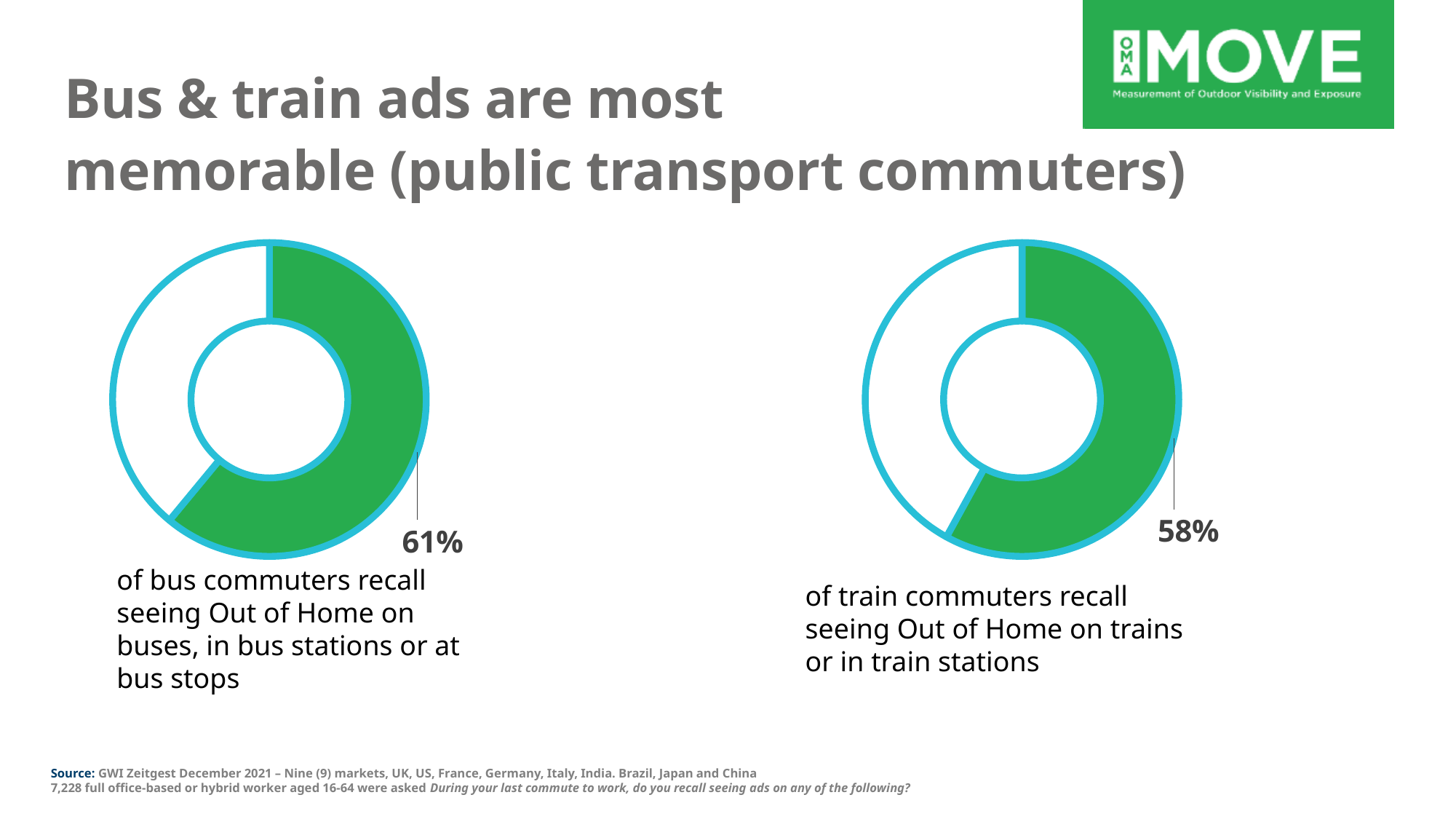
What is the title of the slide containing the two doughnut charts? Bus & train ads are most memorable (public transport commuters) On the right chart, what share of train commuters do not recall seeing Out of Home on trains or in train stations (the white segment)? 42% How many doughnut charts are shown on the slide? 2 On the left chart, what percentage of bus commuters recall seeing Out of Home on buses, in bus stations or at bus stops? 61% What colour is the highlighted segment in both doughnut charts? Green On the left chart, what share of bus commuters do not recall seeing Out of Home on buses, in bus stations or at bus stops (the white segment)? 39% On the right chart, is the green segment for train commuters greater or less than 50%? greater What kind of chart is used on the left of the slide to show the bus commuter figure? Doughnut chart What is the difference in percentage points between the bus commuter figure on the left chart and the train commuter figure on the right chart? 3 percentage points On the right chart, what percentage of train commuters recall seeing Out of Home on trains or in train stations? 58% On the left chart, is the green segment for bus commuters greater or less than 50%? greater Which is larger: the share of bus commuters recalling Out of Home (left chart) or the share of train commuters recalling Out of Home (right chart)? Bus commuters (61%)